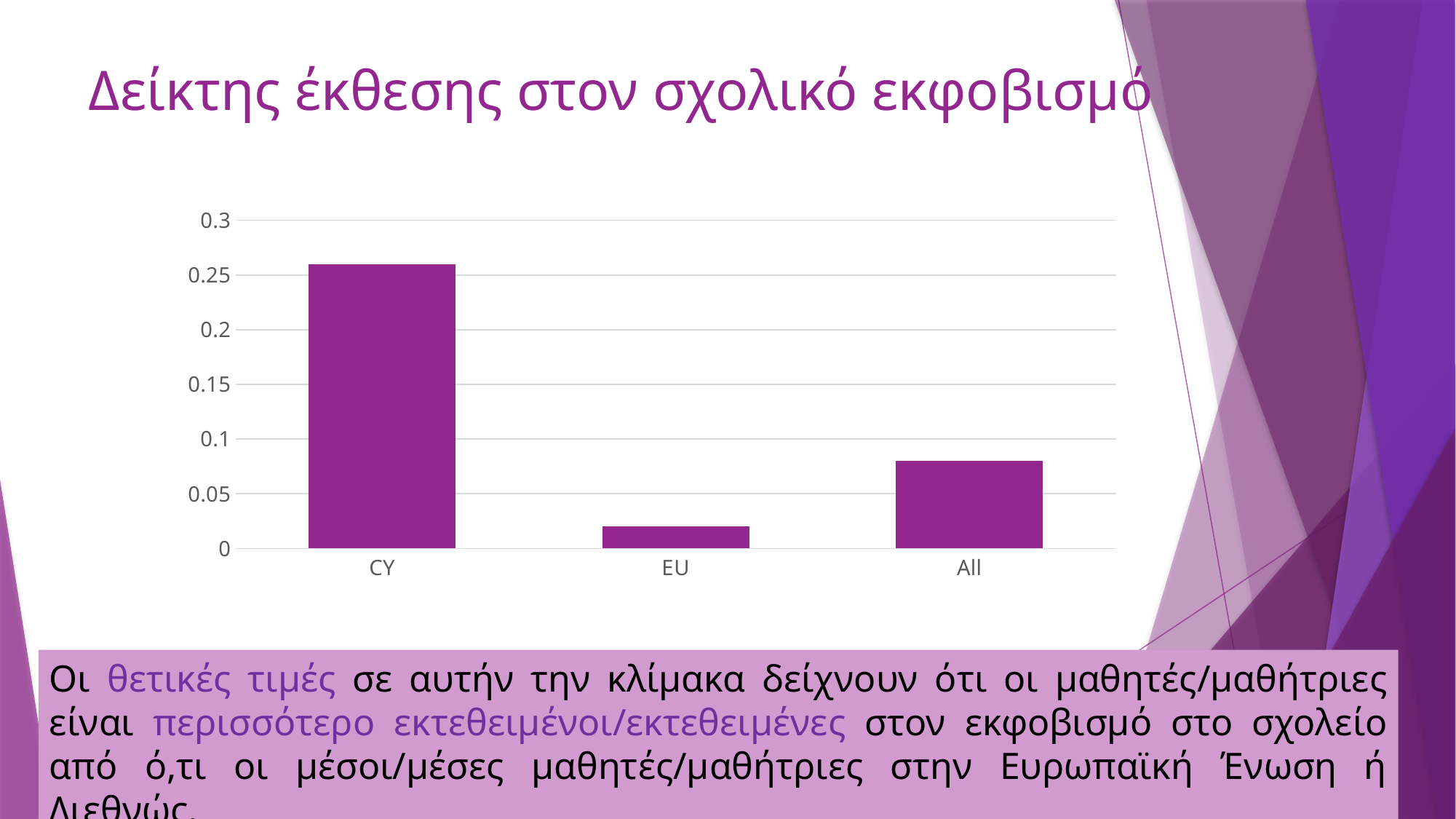
Which has a larger value, CY or All? CY Is the value for EU greater or less than 0.05? less What kind of chart is shown on the slide? bar chart What colour are the bars in the chart? purple Which category has the lowest value in the chart? EU Is the value for All greater or less than 0.05? greater Which category has the highest value in the chart? CY Is the value for CY greater or less than 0.2? greater Which has a larger value, EU or All? All How many categories are shown on the x axis of the chart? 3 What is the title of the slide containing the chart? Δείκτης έκθεσης στον σχολικό εκφοβισμό